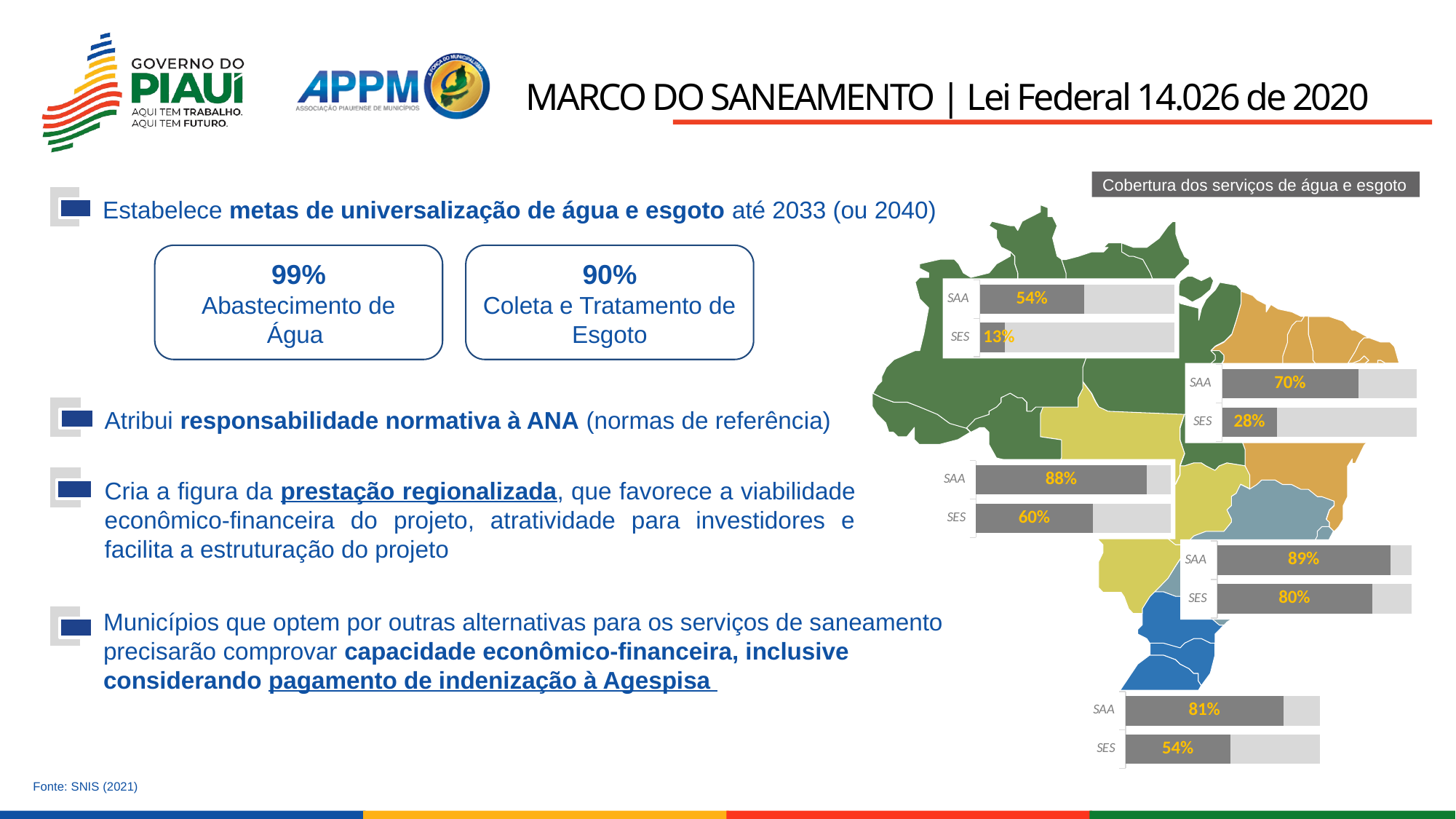
In the bottommost bar chart on the map (below the blue region), which is larger, SAA or SES? SAA In the bottommost bar chart on the map (below the blue region), what is the value for SAA? 81% In the bar chart on the lower right of the map over the blue-grey region, what is the value for SES? 80% In the topmost bar chart on the map (over the green region), what is the value for SAA? 54% What kind of chart is used to show the coverage values on the map? Bar chart In the bar chart on the left side of the map over the yellow region, what is the value for SES? 60% In the bar chart on the right side of the map over the orange region, what is the value for SES? 28% Across all the small bar charts on the map, which chart shows the highest SAA value? The lower-right chart (89%) In the bar chart on the left side of the map over the yellow region, what is the difference between SAA and SES? 28% In the topmost bar chart on the map (over the green region), what is the value for SES? 13% In the bar chart on the right side of the map over the orange region, what is the value for SAA? 70% Across all the small bar charts on the map, which chart shows the lowest SES value? The topmost chart (13%)